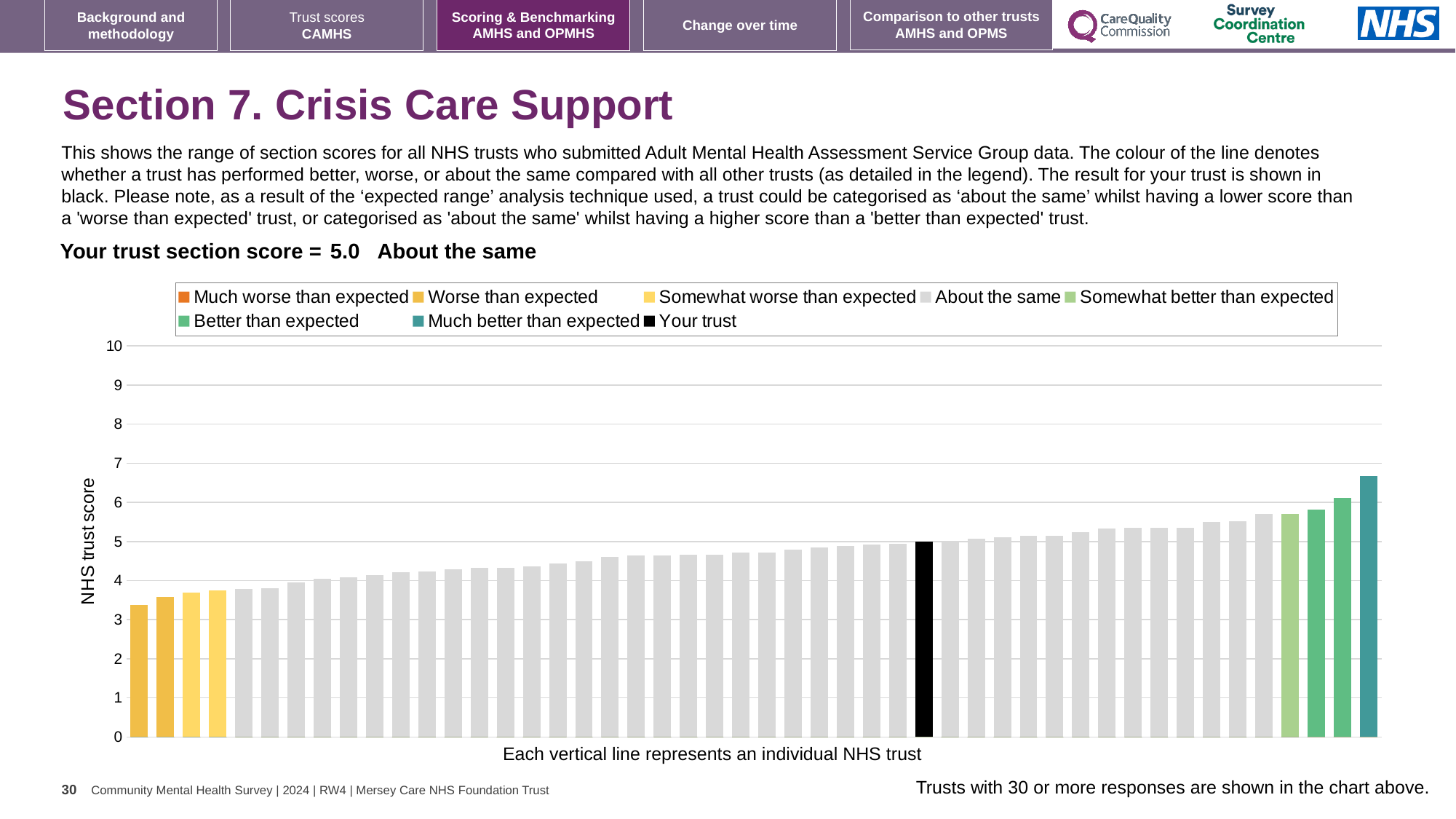
Which category is your trust placed in for this section? About the same What colour is the bar representing your trust? Black Is the value of the black 'Your trust' bar greater or less than 4? greater How many entries does the chart legend list? 8 What kind of chart is shown on the slide? Bar chart What is the section score for your trust, as printed on the slide? 5.0 Do the bar values rise or fall from left to right along the x axis? rise Which legend category does the tallest bar belong to? Much better than expected What is the label on the vertical axis of the chart? NHS trust score Which is larger: the black 'Your trust' bar or the leftmost bar? The black 'Your trust' bar Is the value of the tallest bar greater or less than 6? greater Is the value of the shortest bar greater or less than 4? less